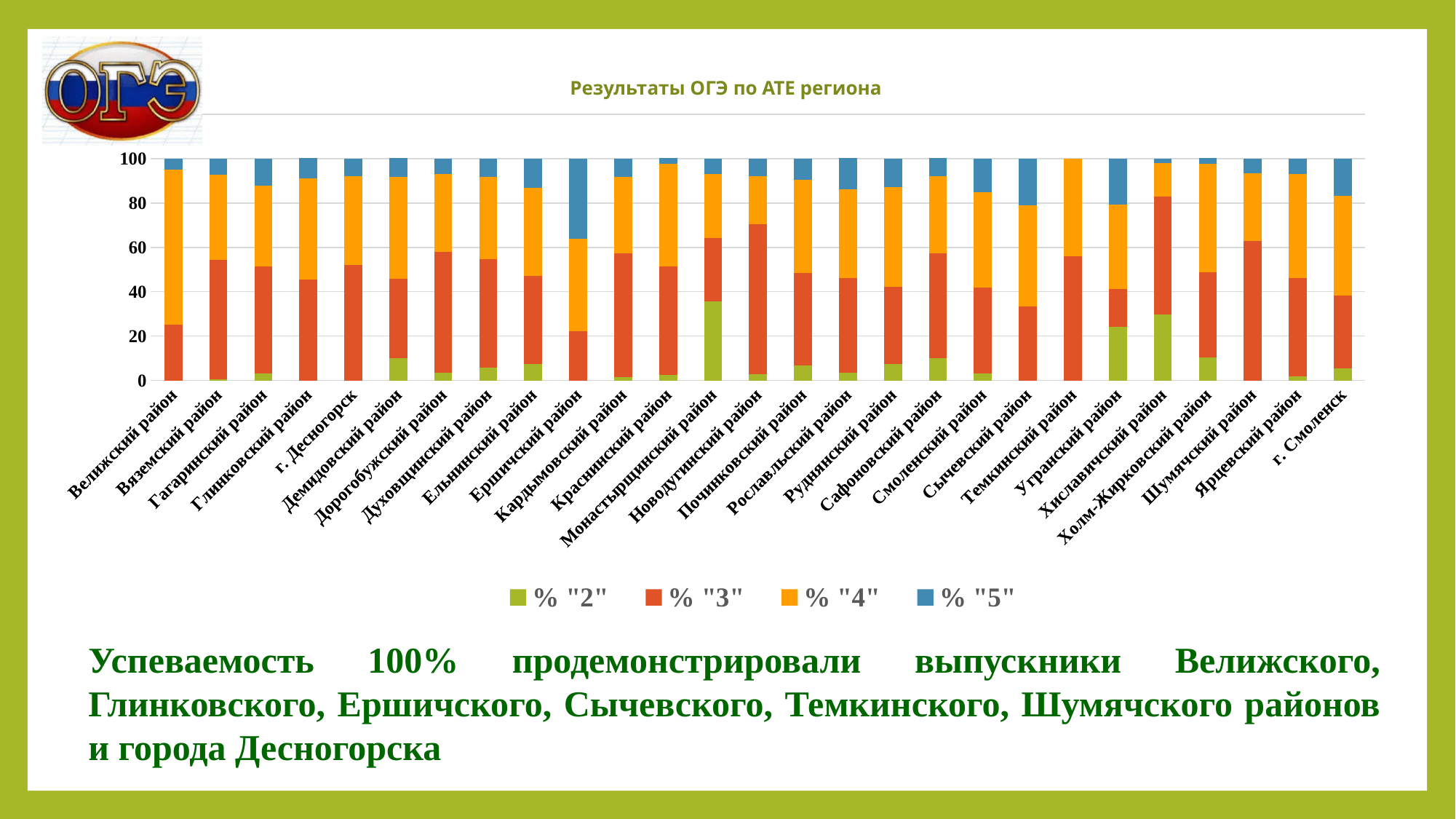
Is the % "5" value for Ершичский район greater or less than 20? greater Is the % "3" value for Велижский район greater or less than 40? less Which category has the largest % "2" segment? Монастырщинский район How many series does the legend list? 4 How many categories (districts/cities) are shown on the x axis? 27 Which category has the largest % "5" segment? Ершичский район Which is larger: the % "3" value for Починковский район or for Велижский район? Починковский район Is the % "3" value for Починковский район greater or less than 60? less What kind of chart is shown on the slide? Stacked bar chart Which colour represents the series % "5" in the legend? Blue What is the title of the chart? Результаты ОГЭ по АТЕ региона Which category has the largest % "4" segment? Велижский район